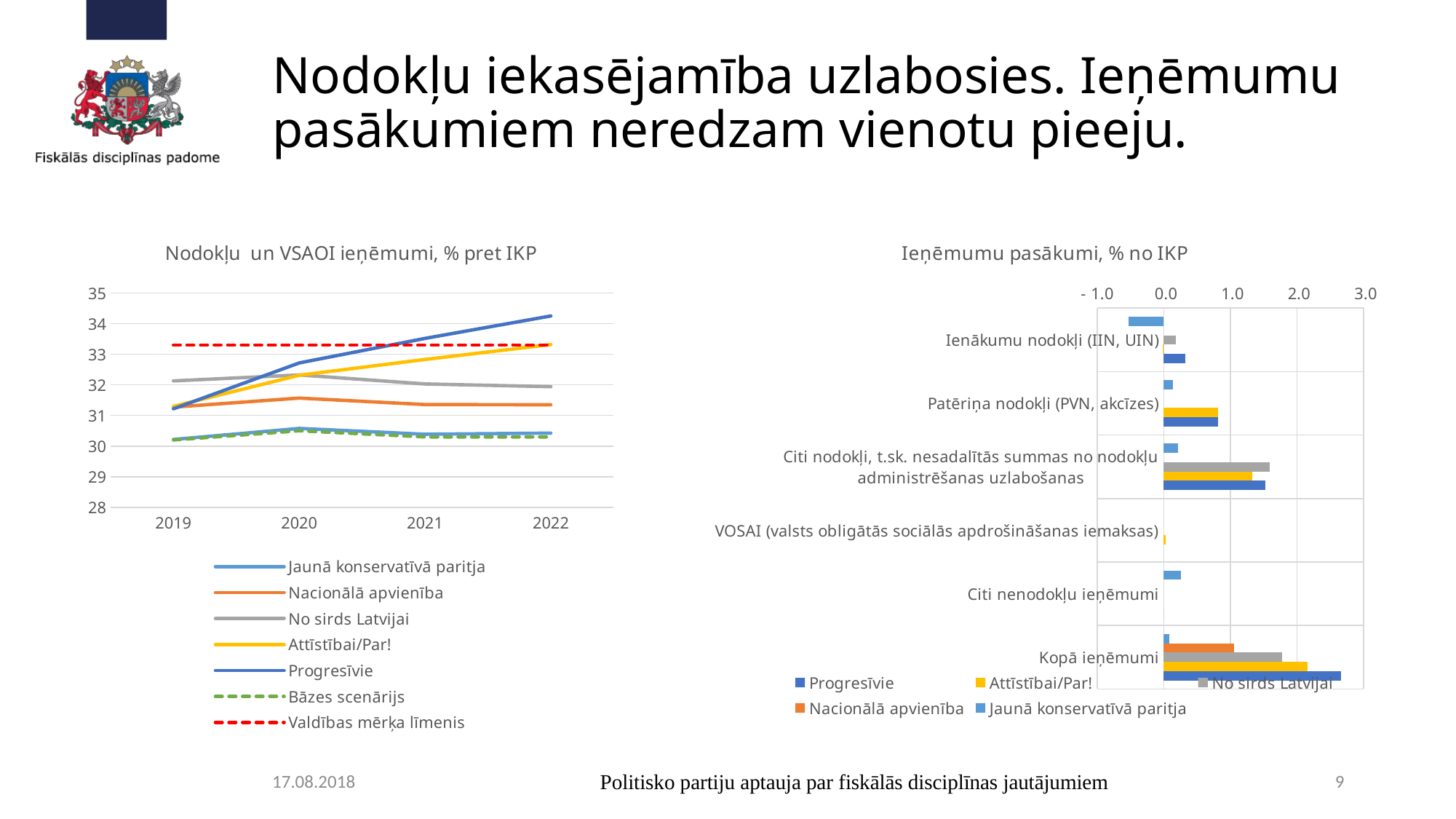
What kind of chart is the left chart titled 'Nodokļu un VSAOI ieņēmumi, % pret IKP'? line chart In the right chart 'Ieņēmumu pasākumi, % no IKP', is the value for Jaunā konservatīvā paritja under Ienākumu nodokļi (IIN, UIN) greater or less than 0.0? less In the left chart 'Nodokļu un VSAOI ieņēmumi, % pret IKP', is the value for Progresīvie in 2022 greater or less than 33? greater In the left chart 'Nodokļu un VSAOI ieņēmumi, % pret IKP', how many series does the legend list? 7 In the right chart 'Ieņēmumu pasākumi, % no IKP', how many series does the legend list? 5 In the right chart 'Ieņēmumu pasākumi, % no IKP', which series has the highest value for Kopā ieņēmumi? Progresīvie In the left chart 'Nodokļu un VSAOI ieņēmumi, % pret IKP', does the Progresīvie line rise or fall from 2019 to 2022? rise In the left chart 'Nodokļu un VSAOI ieņēmumi, % pret IKP', is the value for Nacionālā apvienība in 2022 greater or less than 32? less In the left chart 'Nodokļu un VSAOI ieņēmumi, % pret IKP', how many years are shown on the x axis? 4 In the left chart 'Nodokļu un VSAOI ieņēmumi, % pret IKP', which series has the highest value in 2022? Progresīvie In the right chart 'Ieņēmumu pasākumi, % no IKP', how many categories are shown on the vertical axis? 6 What kind of chart is the right chart titled 'Ieņēmumu pasākumi, % no IKP'? bar chart